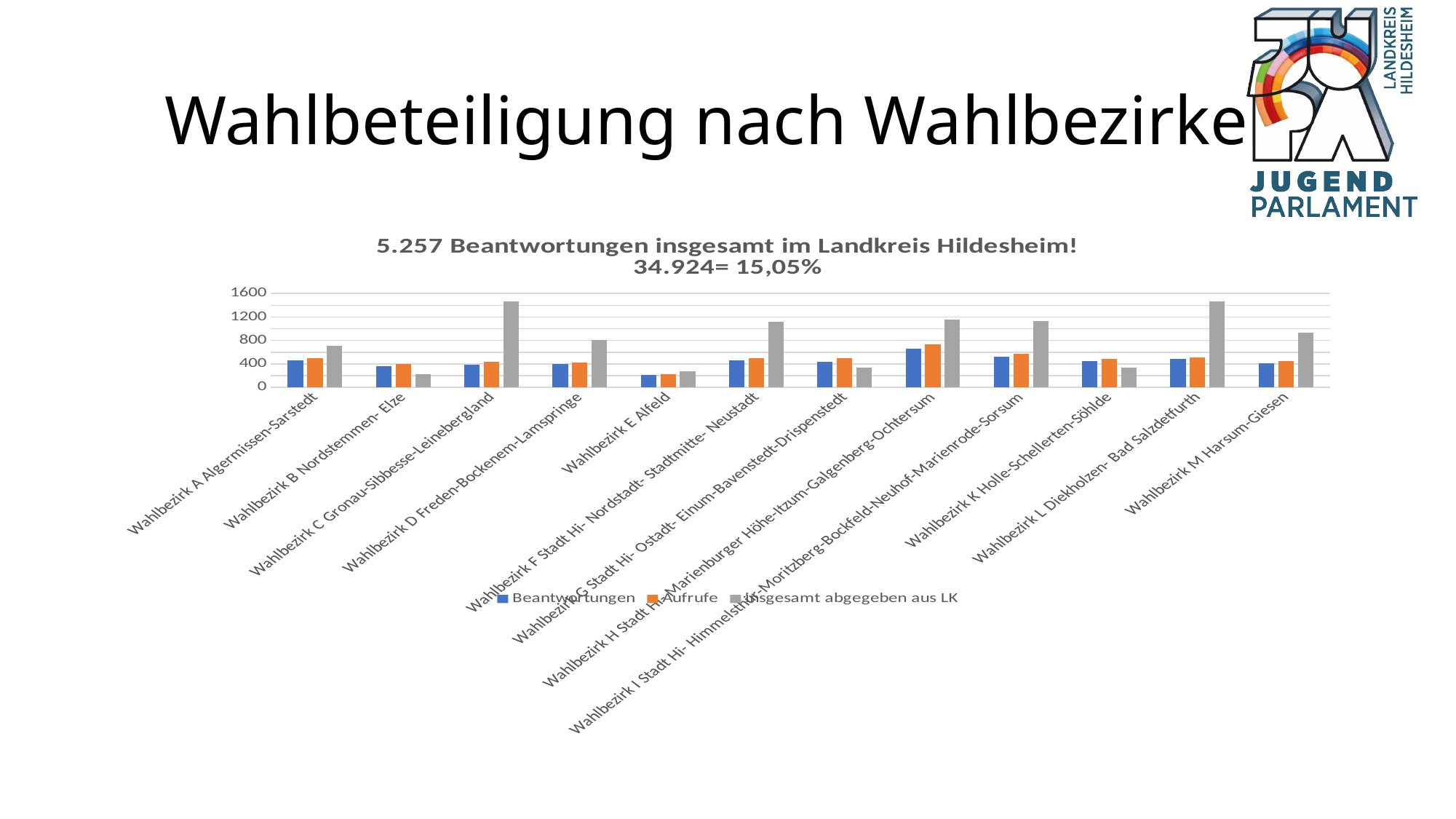
Is the value for 'Aufrufe' in Wahlbezirk H Stadt Hi- Marienburger Höhe-Itzum-Galgenberg-Ochtersum greater or less than 400? greater Which Wahlbezirk has the lowest value for 'Insgesamt abgegeben aus LK'? Wahlbezirk B Nordstemmen- Elze How many series does the chart's legend list? 3 How many Wahlbezirke (categories) are shown on the x axis of the chart? 12 In Wahlbezirk G Stadt Hi- Ostadt- Einum-Bavenstedt-Drispenstedt, which is larger: 'Aufrufe' or 'Insgesamt abgegeben aus LK'? Aufrufe In Wahlbezirk F Stadt Hi- Nordstadt- Stadtmitte- Neustadt, which is larger: 'Beantwortungen' or 'Insgesamt abgegeben aus LK'? Insgesamt abgegeben aus LK Which Wahlbezirk has the highest value for 'Beantwortungen'? Wahlbezirk H Stadt Hi- Marienburger Höhe-Itzum-Galgenberg-Ochtersum What kind of chart is shown on the slide? bar chart Which Wahlbezirk has the lowest value for 'Beantwortungen'? Wahlbezirk E Alfeld Is the value for 'Insgesamt abgegeben aus LK' in Wahlbezirk E Alfeld greater or less than 400? less Which series is shown in gray in the chart's legend? Insgesamt abgegeben aus LK Is the value for 'Insgesamt abgegeben aus LK' in Wahlbezirk C Gronau-Sibbesse-Leinebergland greater or less than 1200? greater